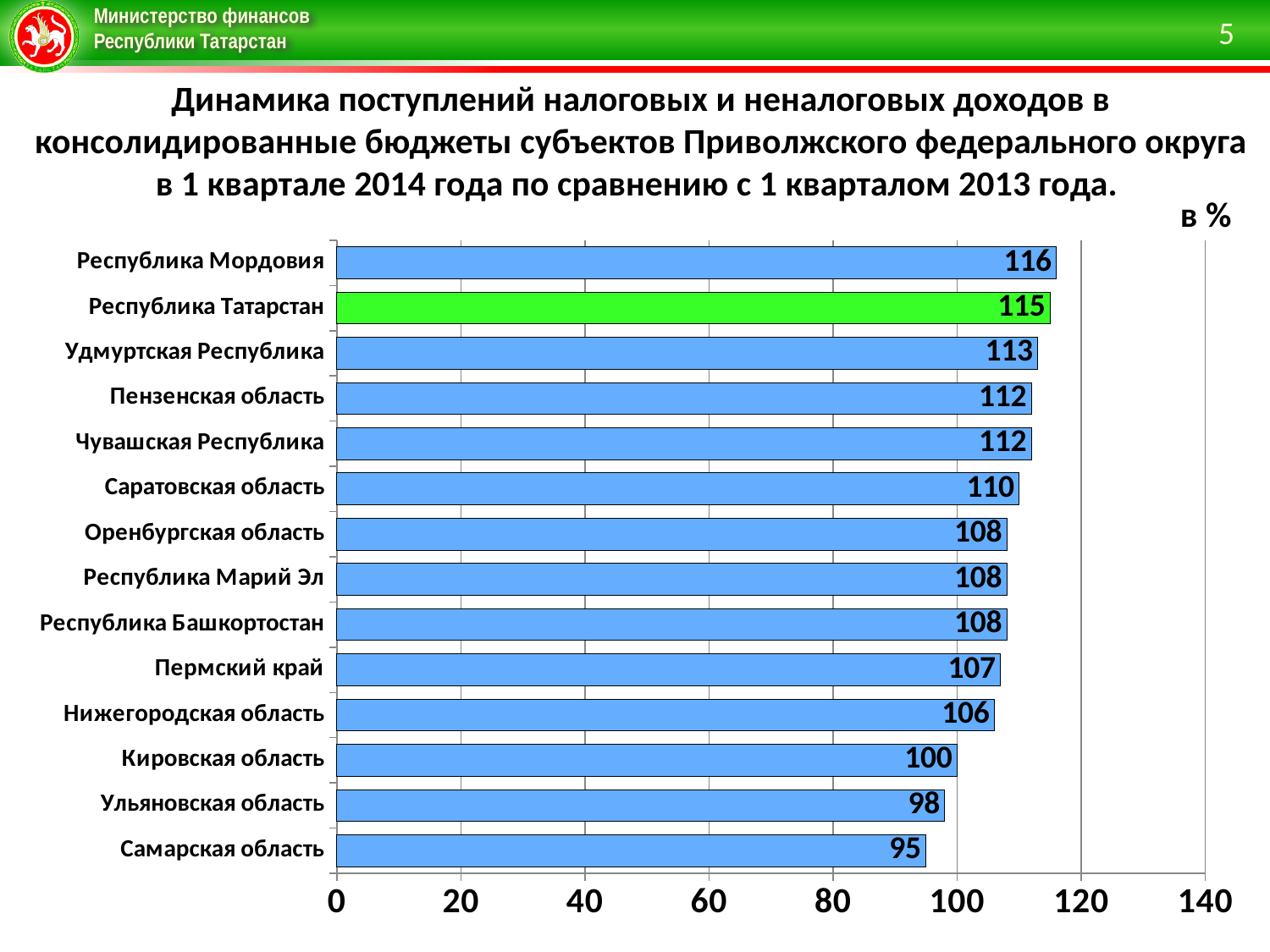
What is the value for Республика Татарстан? 115 Which is larger, the value for Пермский край or the value for Ульяновская область? Пермский край Which region has the highest value? Республика Мордовия Which region's bar is coloured green instead of blue? Республика Татарстан Is the value for Саратовская область greater or less than 100? greater Which region has the lowest value? Самарская область What unit is indicated in the top right corner of the chart? в % What is the difference between the values for Республика Мордовия and Самарская область? 21 How many regions are shown in the chart? 14 What is the value for Самарская область? 95 What kind of chart is shown on the slide? bar chart What is the value for Кировская область? 100